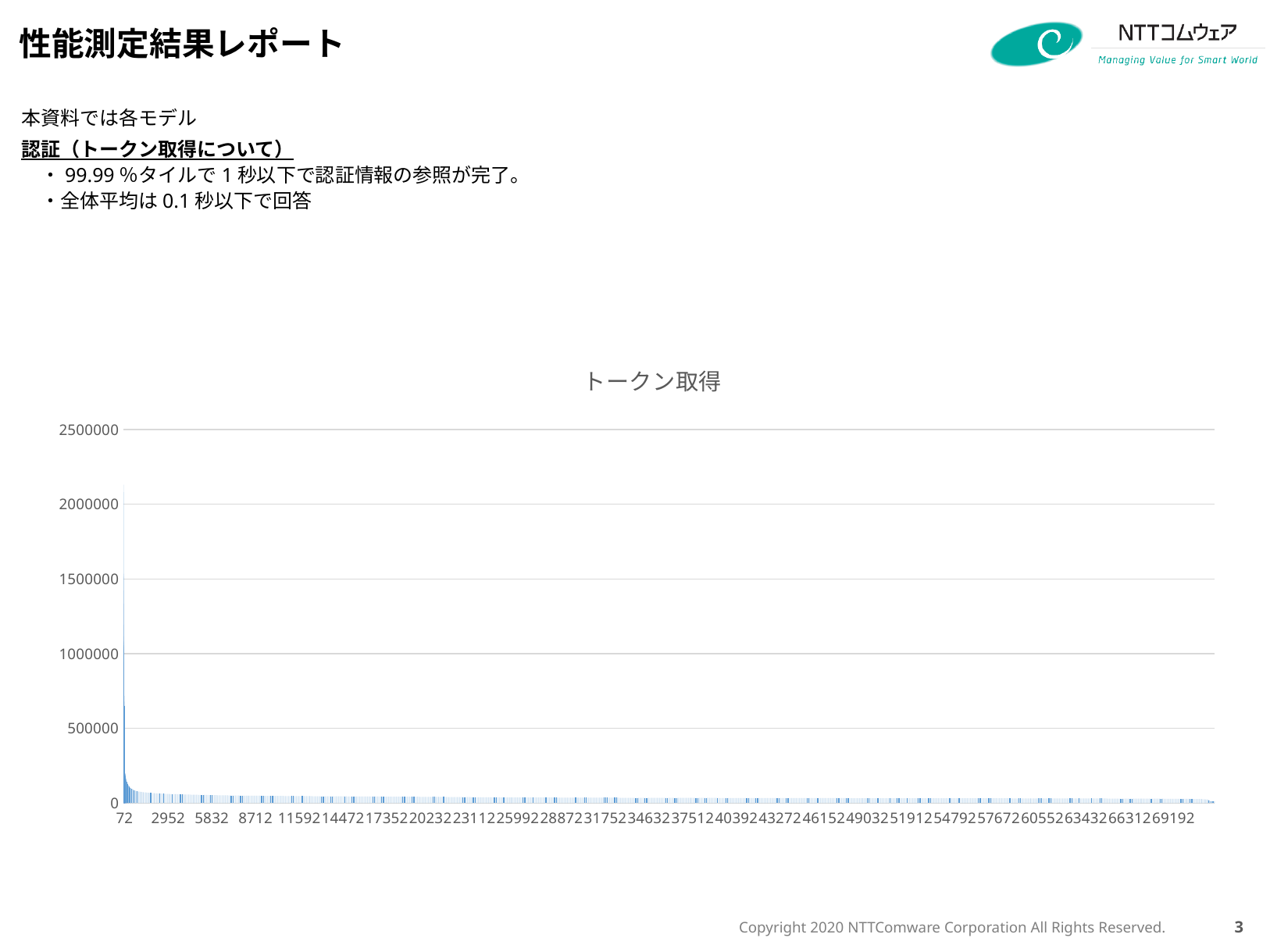
Which is larger in the トークン取得 chart: the value for 72 or the value for 2952? 72 What kind of chart is shown under the title トークン取得? bar chart Do the values in the トークン取得 chart rise or fall as you move from left to right along the x axis? fall Is the value for the category 69192 in the トークン取得 chart greater or less than 500000? less Is the value for the category 34632 in the トークン取得 chart greater or less than 500000? less What is the first label on the x axis of the トークン取得 chart? 72 What is the highest value shown on the y axis of the トークン取得 chart? 2500000 What is the last label on the x axis of the トークン取得 chart? 69192 What is the title of the chart on the slide? トークン取得